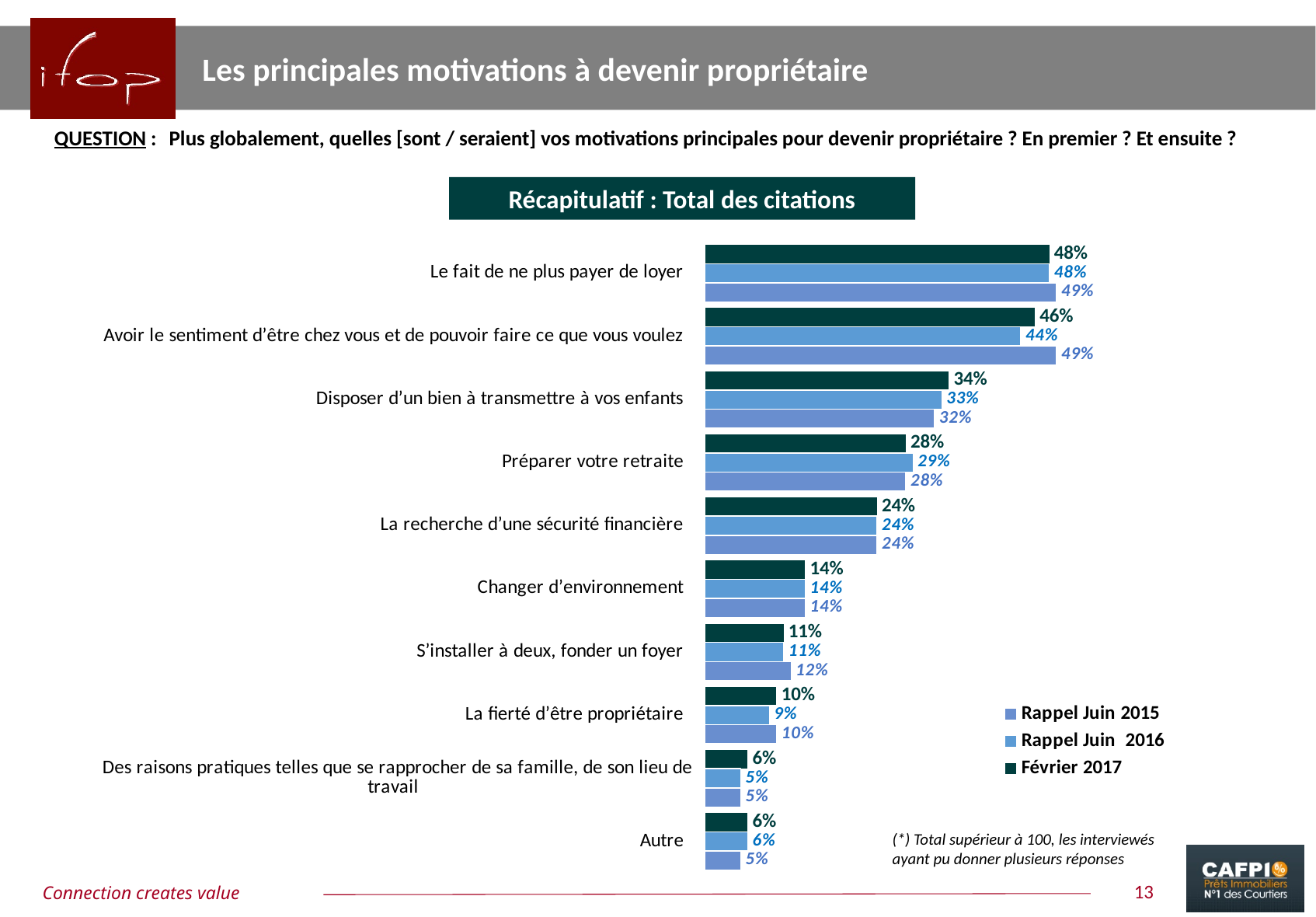
How many series does the legend list? 3 Which category has the highest Février 2017 value? Le fait de ne plus payer de loyer What is the Rappel Juin 2016 value for "Préparer votre retraite"? 29% What is the title shown in the box above the chart? Récapitulatif : Total des citations What is the difference between the Février 2017 and Rappel Juin 2016 values for "Avoir le sentiment d'être chez vous et de pouvoir faire ce que vous voulez"? 2% Which category has the lowest Rappel Juin 2016 value? Des raisons pratiques telles que se rapprocher de sa famille, de son lieu de travail What is the Février 2017 value for "Le fait de ne plus payer de loyer"? 48% What is the Rappel Juin 2016 value for "La fierté d'être propriétaire"? 9% What is the Rappel Juin 2015 value for "Avoir le sentiment d'être chez vous et de pouvoir faire ce que vous voulez"? 49% What kind of chart is shown on the slide? Bar chart For "Disposer d'un bien à transmettre à vos enfants", which is larger: the Février 2017 value or the Rappel Juin 2015 value? Février 2017 How many categories (motivations) are plotted in the chart? 10